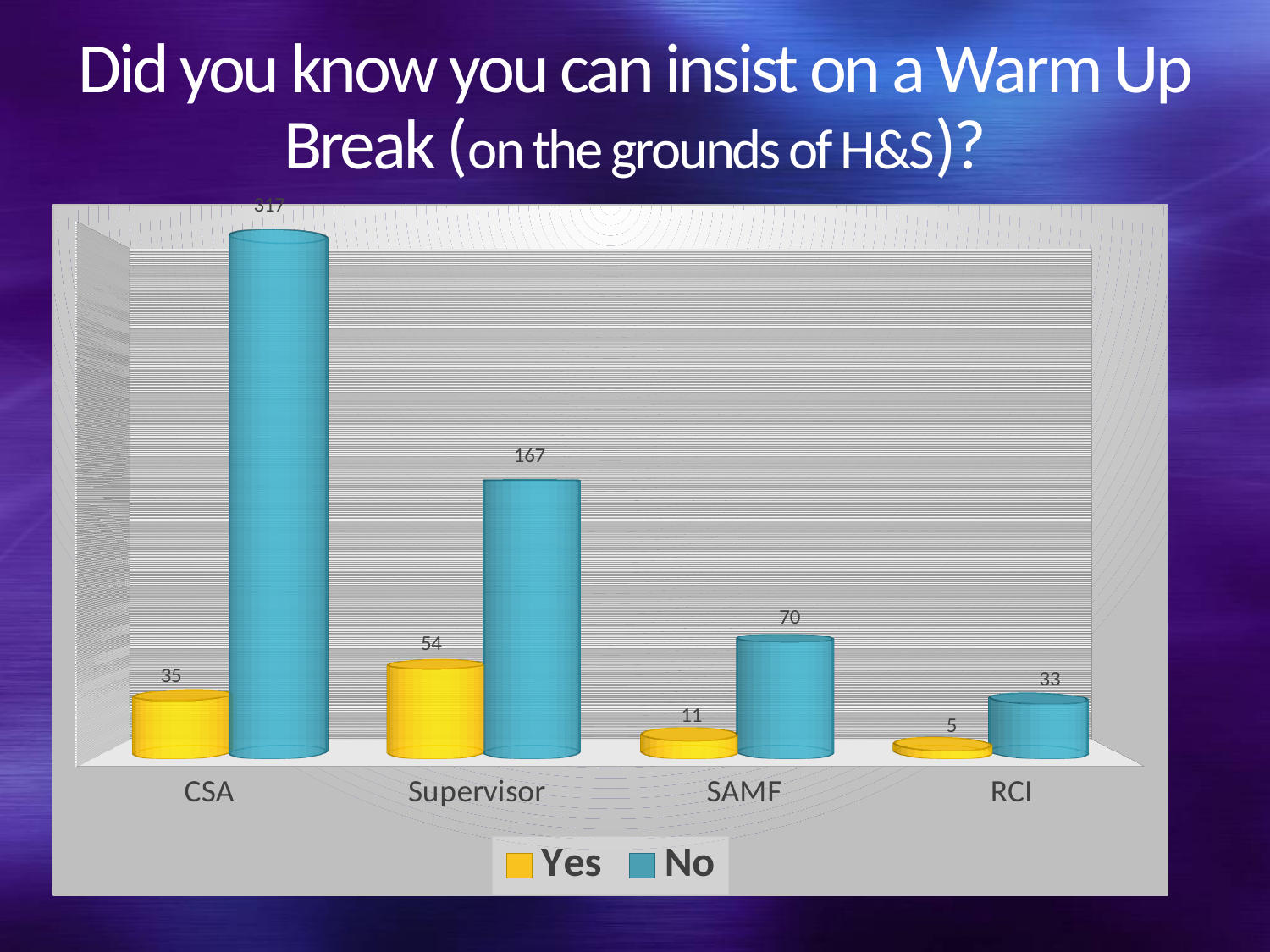
What kind of chart is shown on the slide? Bar chart Which category has the highest 'No' value? CSA What is the 'Yes' value for Supervisor? 54 Which category has the lowest 'Yes' value? RCI Which is larger: the 'Yes' value for CSA or the 'No' value for RCI? Yes value for CSA What is the 'Yes' value for RCI? 5 Which colour represents the 'Yes' series in the legend? Yellow What is the 'No' value for SAMF? 70 What is the difference between the 'No' and 'Yes' values for Supervisor? 113 How many series does the legend list? 2 How many categories are shown on the x axis? 4 What is the 'No' value for CSA? 317